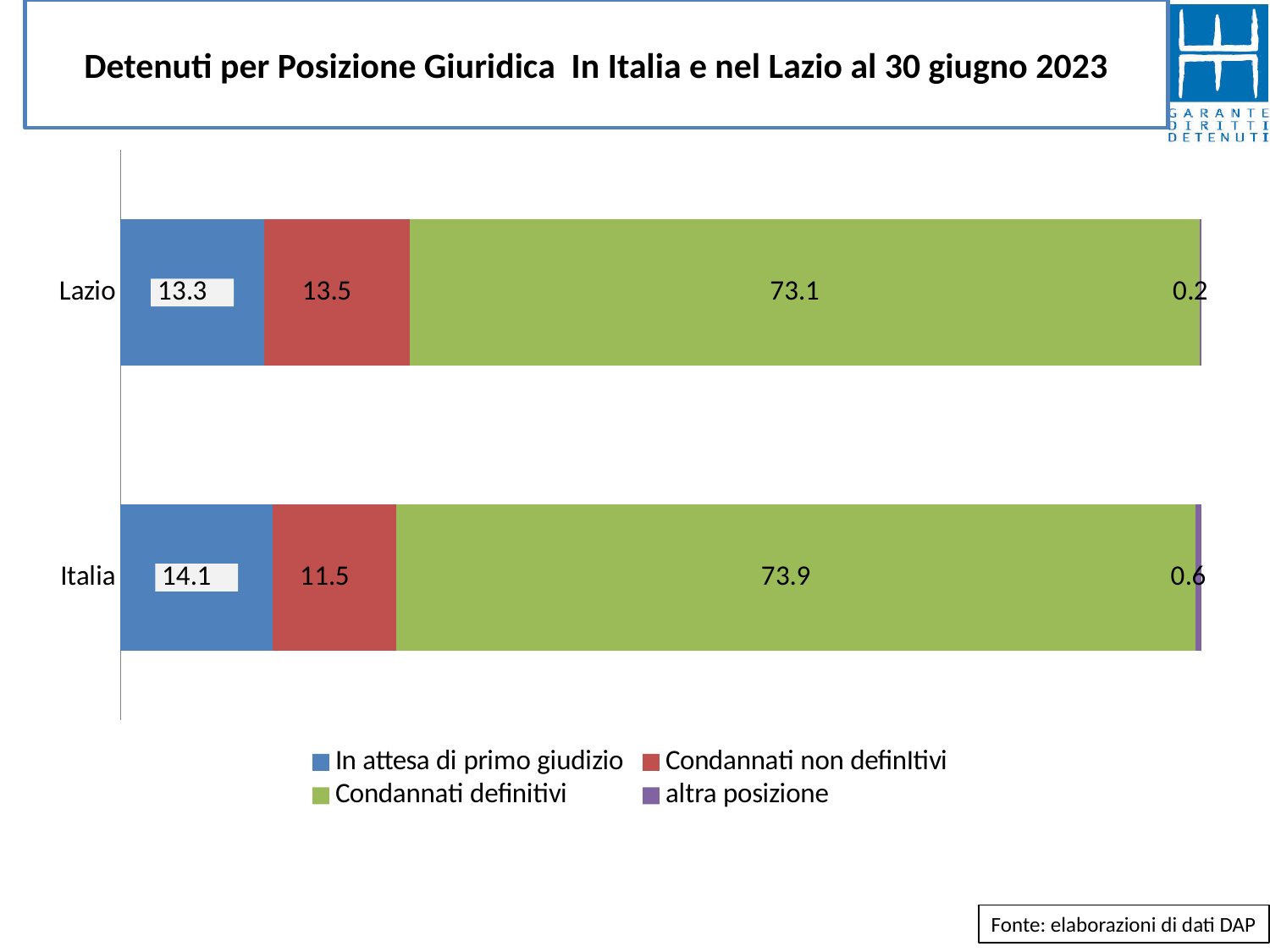
How many series does the legend list? 4 Which series has the highest value for Italia? Condannati definitivi What is the difference between the Condannati non definitivi values for Lazio and Italia? 2.0 What kind of chart is shown on the slide? Stacked bar chart How many categories are shown on the chart? 2 Which is larger, the In attesa di primo giudizio value for Lazio or for Italia? Italia What is the value for altra posizione in Italia? 0.6 What is the total of the stacked bar for Lazio? 100.1 Which series has the lowest value for Lazio? altra posizione What is the value for Condannati non definitivi in Lazio? 13.5 What is the value for Condannati definitivi in Lazio? 73.1 What is the value for In attesa di primo giudizio in Italia? 14.1